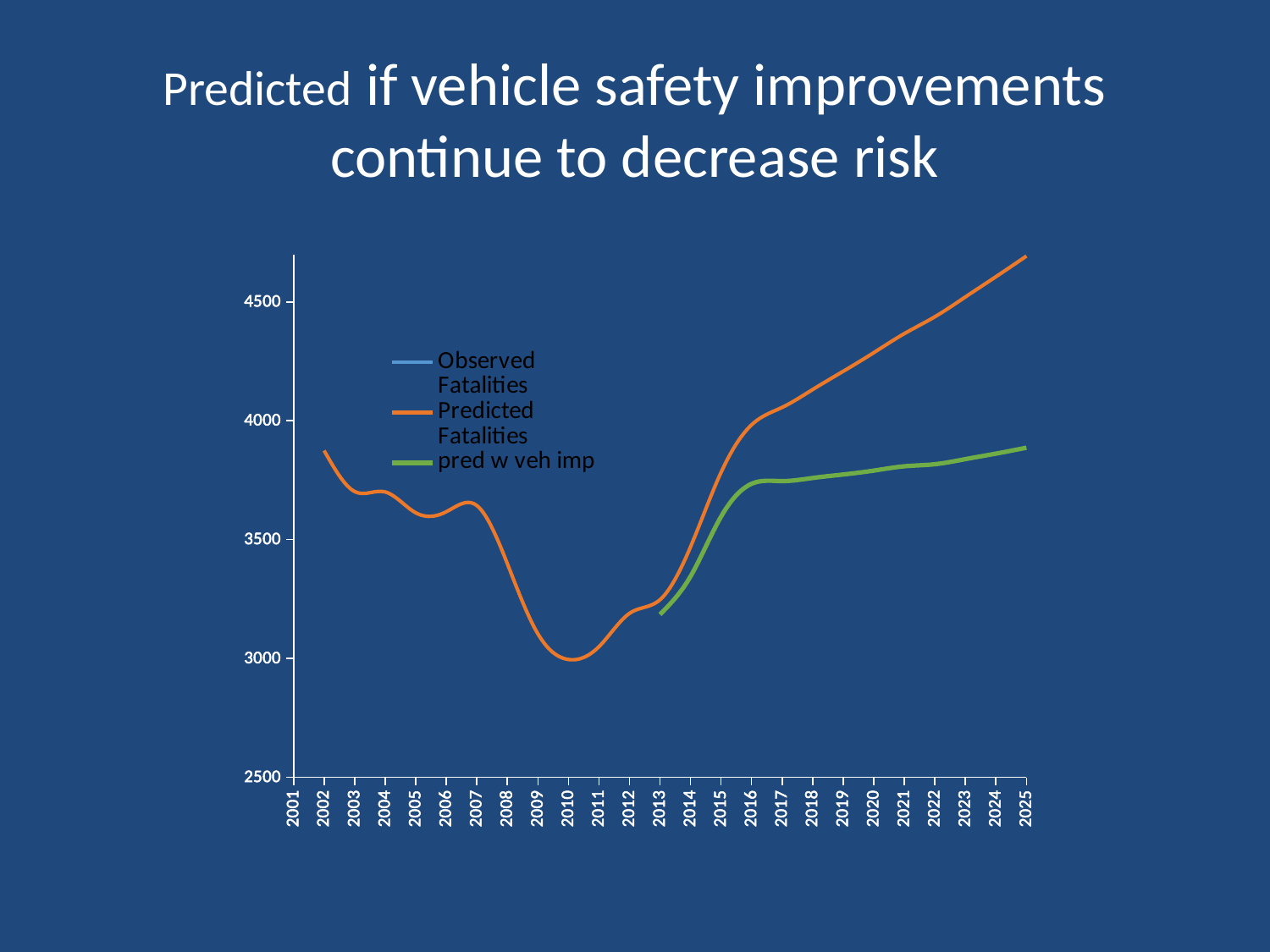
Is the value of Predicted Fatalities in 2002 greater or less than 3500? greater How many series does the legend list? 3 In which year does the Predicted Fatalities line reach its lowest point? 2010 In 2025, which series has the higher value: Predicted Fatalities or pred w veh imp? Predicted Fatalities Does the Predicted Fatalities line rise or fall between 2016 and 2025? rise What kind of chart is shown on the slide? line chart What is the title of the slide? Predicted if vehicle safety improvements continue to decrease risk What colour is the line for the 'pred w veh imp' series? green Is the value of Predicted Fatalities in 2010 greater or less than 3500? less Is the value of Predicted Fatalities in 2025 greater or less than 4500? greater Does the Predicted Fatalities line rise or fall between 2007 and 2010? fall